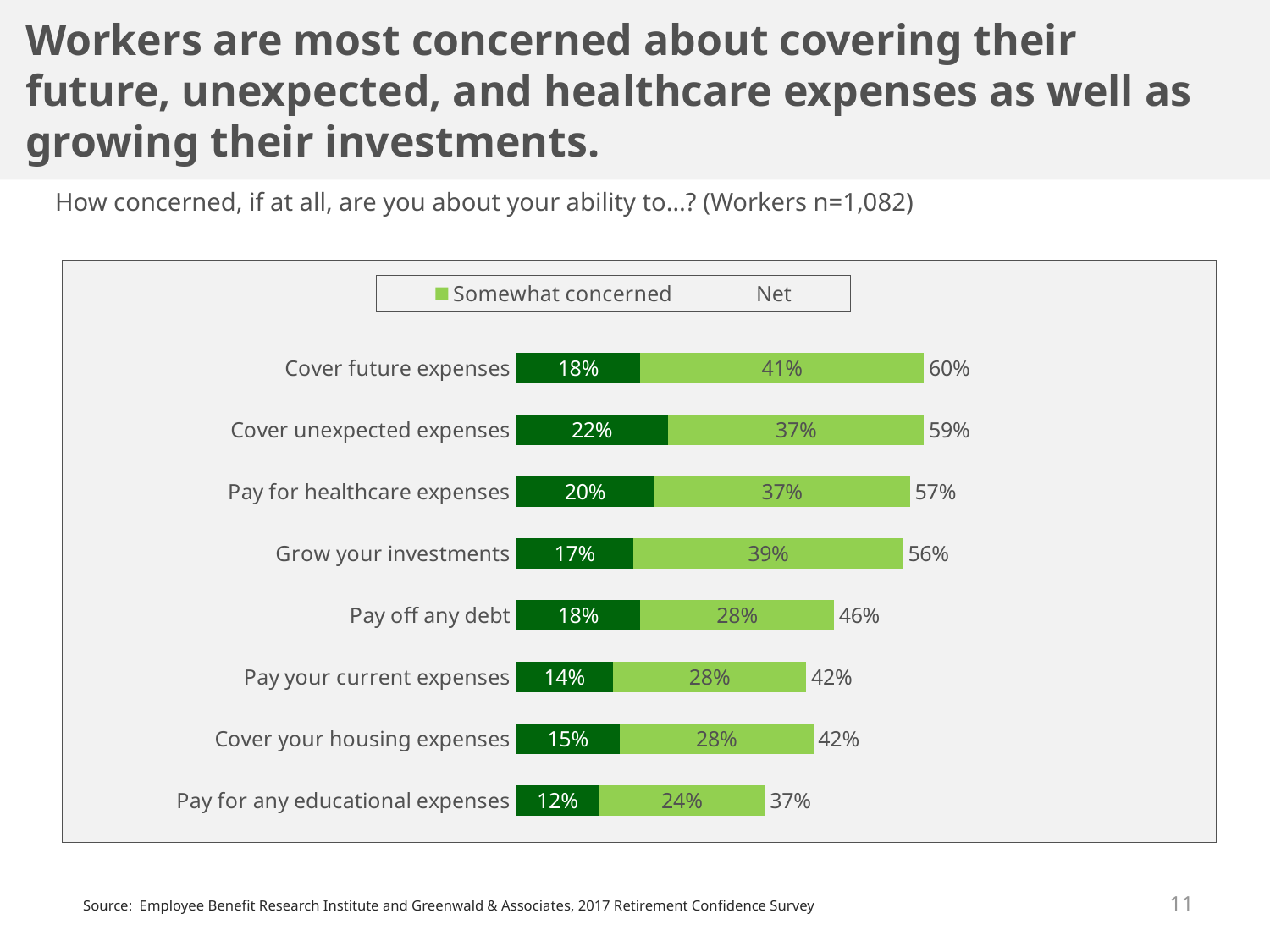
What kind of chart is shown on the slide? Stacked bar chart What is the value of the dark green segment for "Cover unexpected expenses"? 22% Which category has the highest Net value? Cover future expenses What is the Net value for "Pay for healthcare expenses"? 57% What is the difference between the Net values for "Cover future expenses" and "Pay your current expenses"? 18 percentage points What colour represents "Somewhat concerned" in the legend? Light green Which category has the lowest Net value? Pay for any educational expenses What is the "Somewhat concerned" value for "Cover future expenses"? 41% Which has a larger "Somewhat concerned" value: "Grow your investments" or "Cover unexpected expenses"? Grow your investments How many categories are shown in the chart? 8 What is the Net value for "Pay off any debt"? 46% What is the difference between the "Somewhat concerned" values for "Cover future expenses" and "Pay for any educational expenses"? 17 percentage points